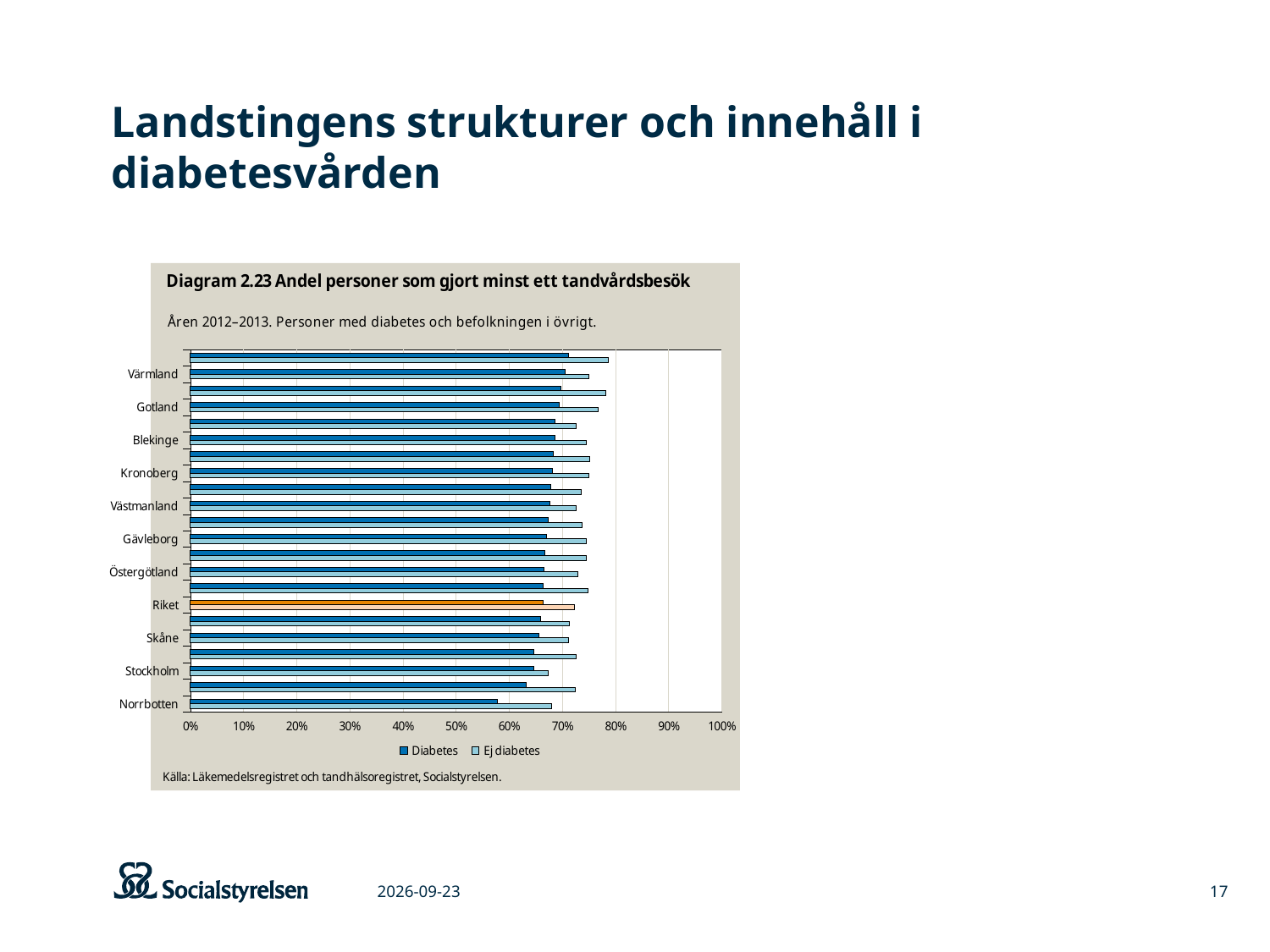
What are the two series named in the legend? Diabetes and Ej diabetes For Norrbotten, which is larger, the Diabetes value or the Ej diabetes value? Ej diabetes What kind of chart is shown on the slide? Bar chart Is the Ej diabetes value for Värmland greater or less than 70%? greater Is the Diabetes value for Stockholm greater or less than 70%? less Which labelled region has the lowest Diabetes value? Norrbotten Is the Ej diabetes value for Norrbotten greater or less than 60%? greater How many series does the legend list? 2 Which category is drawn in orange instead of blue? Riket Which has the larger Diabetes value, Värmland or Norrbotten? Värmland